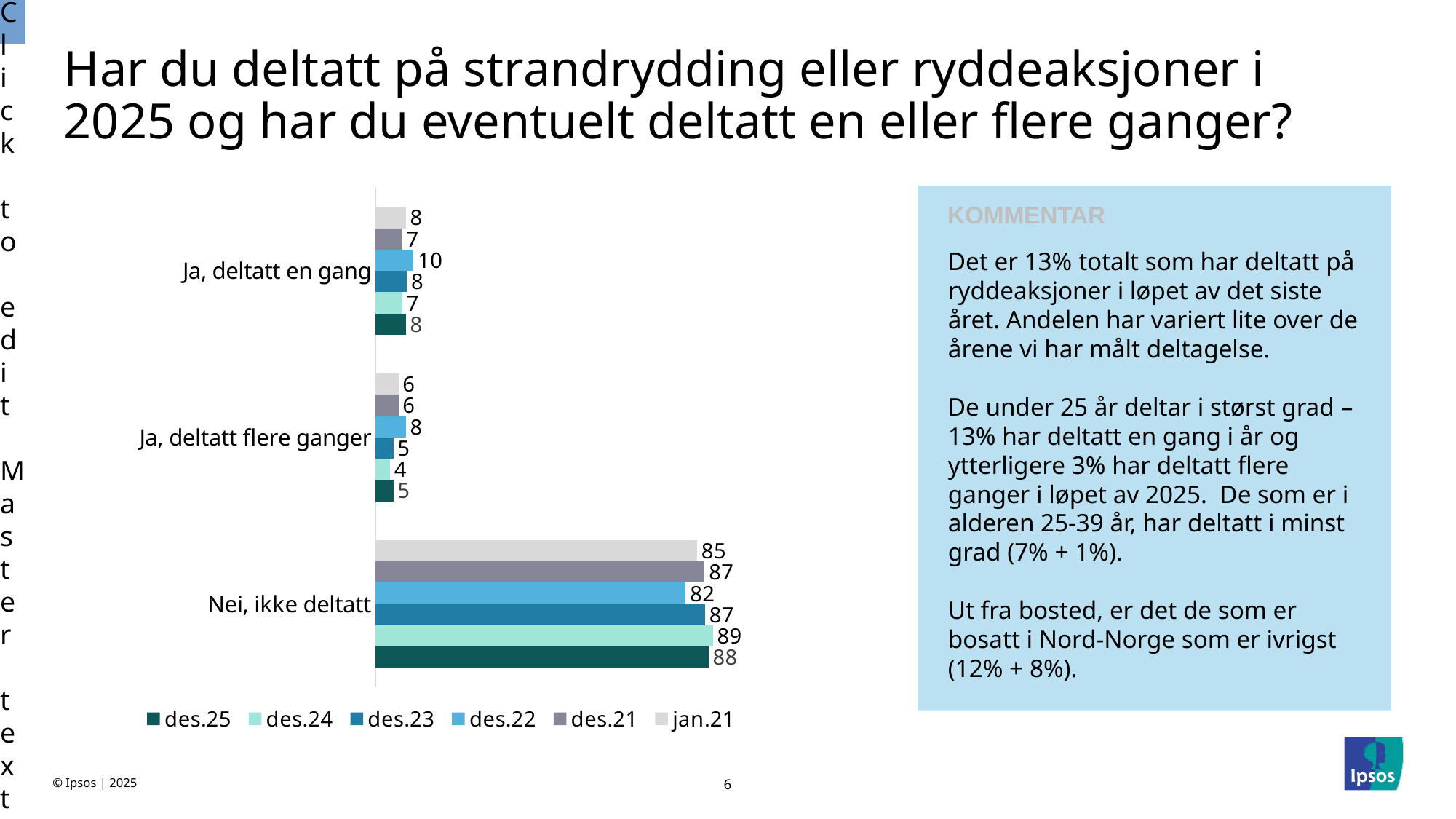
Which series has the highest value in the category "Nei, ikke deltatt"? des.24 How many series does the legend list? 6 What is the value for jan.21 in the category "Nei, ikke deltatt"? 85 What is the difference between the des.24 and des.22 values in the category "Nei, ikke deltatt"? 7 What type of chart is shown on the slide? bar chart In the category "Ja, deltatt flere ganger", which is larger: the value for des.22 or the value for des.23? des.22 What is the value for des.24 in the category "Ja, deltatt flere ganger"? 4 Which series has the lowest value in the category "Nei, ikke deltatt"? des.22 What is the value for des.25 in the category "Nei, ikke deltatt"? 88 How many categories are shown on the chart? 3 Which legend entry is shown in the darkest teal colour? des.25 What is the value for des.22 in the category "Ja, deltatt en gang"? 10